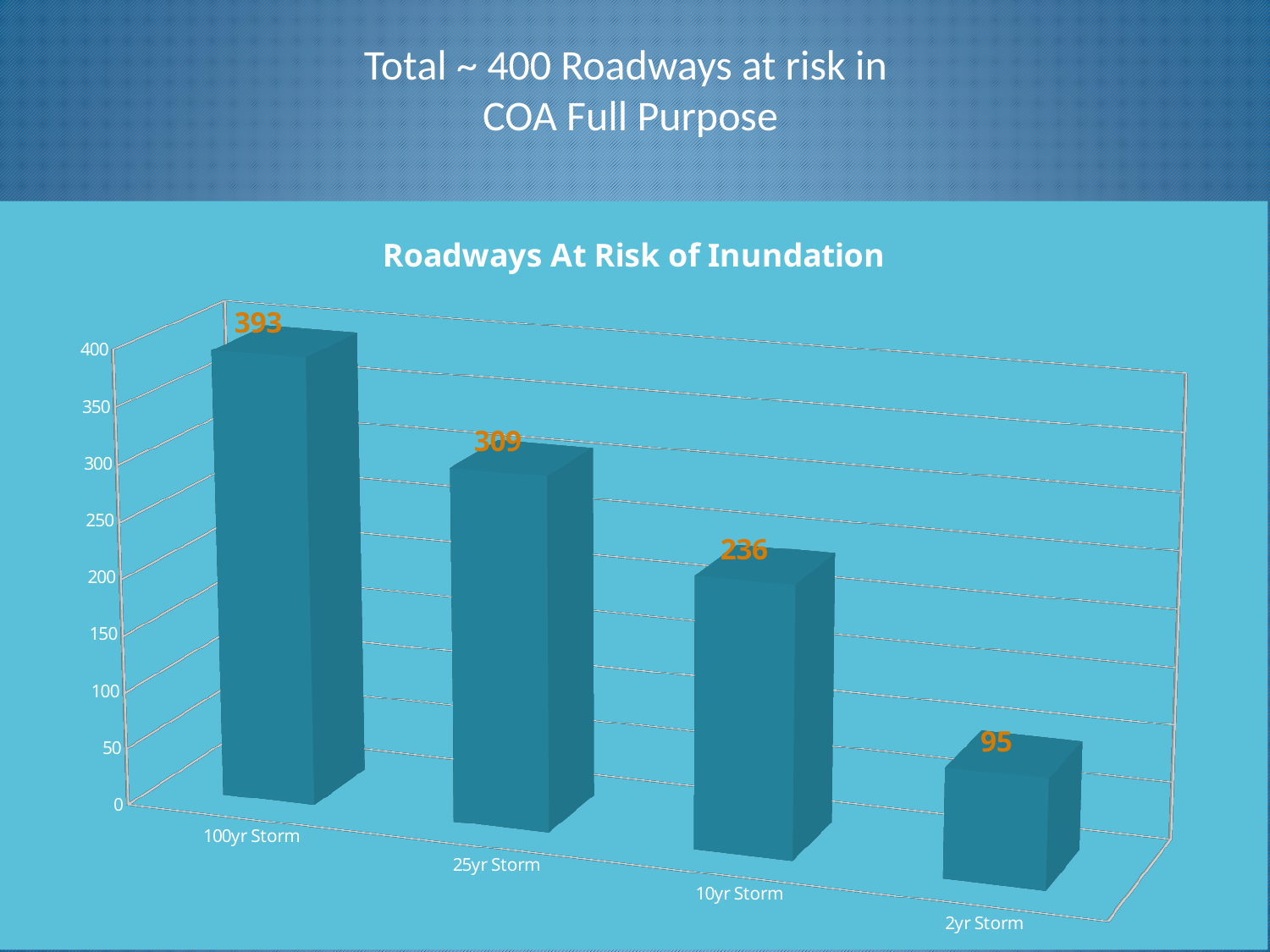
What kind of chart is shown on the slide? Bar chart What is the difference between the values for 25yr Storm and 10yr Storm? 73 What is the value for 2yr Storm? 95 What is the value for 25yr Storm? 309 What is the difference between the values for 100yr Storm and 2yr Storm? 298 Which storm category has the lowest number of roadways at risk? 2yr Storm What is the title of the chart? Roadways At Risk of Inundation What is the value for 100yr Storm? 393 Which is larger, the value for 25yr Storm or the value for 10yr Storm? 25yr Storm How many storm categories are shown in the chart? 4 What is the value for 10yr Storm? 236 Which storm category has the highest number of roadways at risk? 100yr Storm